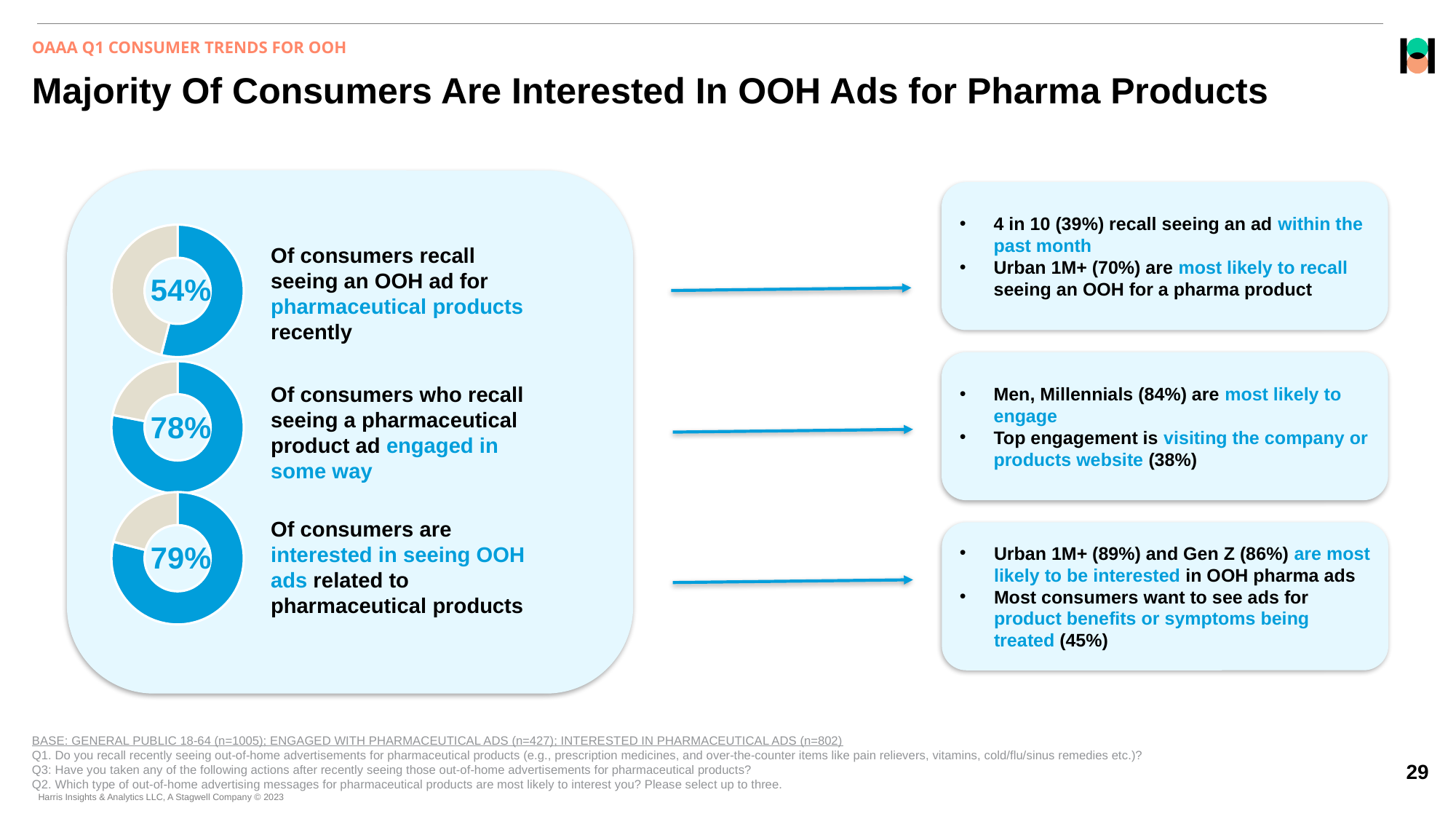
How many donut charts are shown on the slide? 3 Which of the three donut charts shows the highest percentage? The bottom one (interested in seeing OOH ads), 79% What percentage is shown in the top donut chart, for consumers who recall seeing an OOH ad for pharmaceutical products recently? 54% What percentage is shown in the bottom donut chart, for consumers interested in seeing OOH ads related to pharmaceutical products? 79% Which of the three donut charts shows the lowest percentage? The top one (recall seeing an OOH ad), 54% Is the value in the top donut chart greater or less than 50%? greater What colour is used for the highlighted (value) segment in each donut chart? Blue What is the difference in percentage points between the bottom donut chart (79%) and the top donut chart (54%)? 25 percentage points Which is larger: the percentage of consumers who engaged in some way or the percentage who recall seeing an OOH ad for pharmaceutical products? Engaged in some way (78%) What kind of charts are used on the left side of the slide? Donut (pie) charts In the bottom donut chart, what share of the ring is filled by the blue segment? 79% What percentage is shown in the middle donut chart, for consumers who recall seeing a pharmaceutical product ad and engaged in some way? 78%